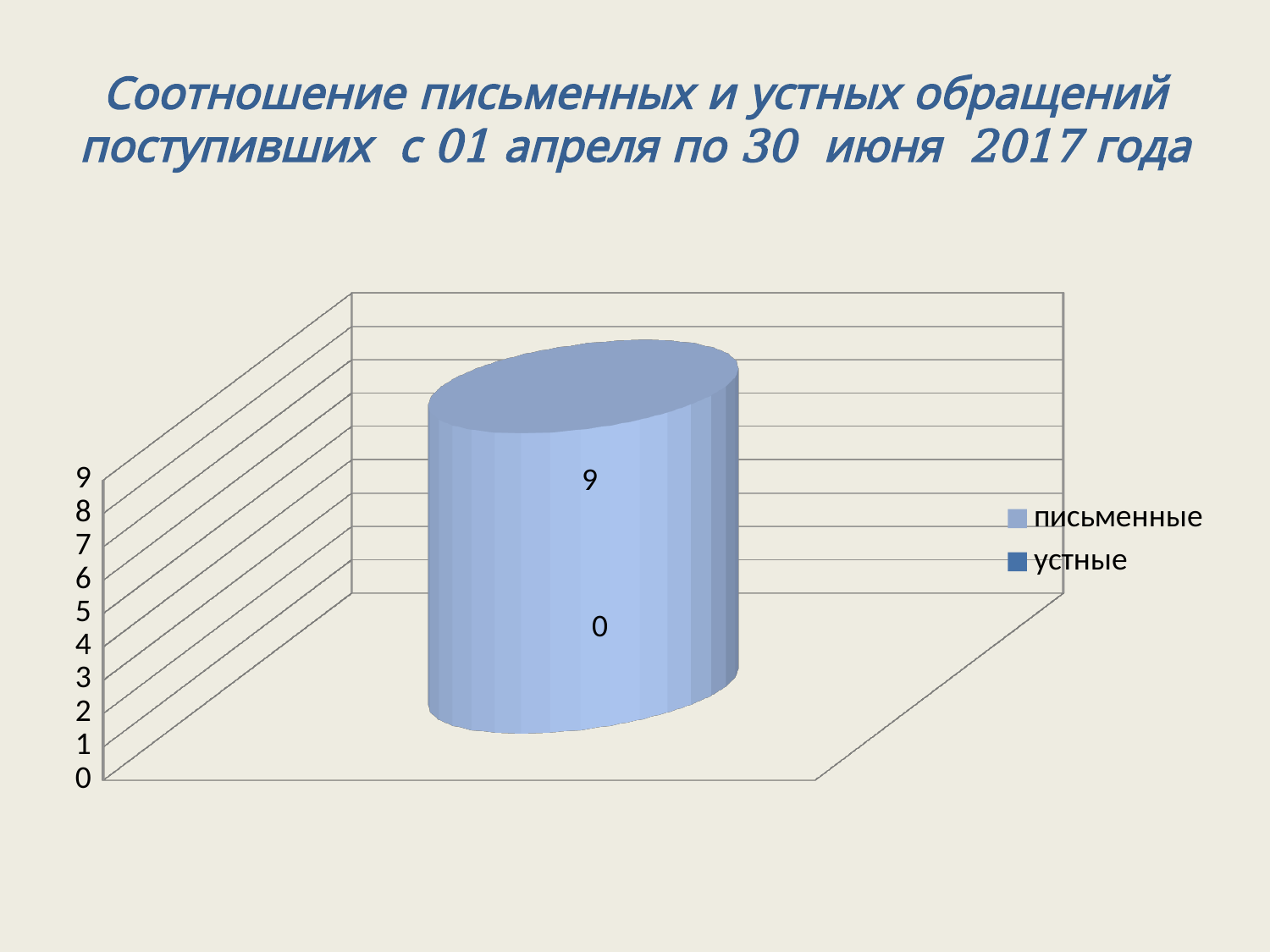
What is the difference between the values for письменные and устные? 9 What period does the chart title say the обращения were received in? с 01 апреля по 30 июня 2017 года What is the highest value shown on the vertical axis? 9 What kind of chart is shown on the slide? bar chart How many series does the legend list? 2 What is the total of the values for письменные and устные? 9 Which series has the higher value, письменные or устные? письменные Is the value for письменные greater or less than 5? greater What is the value for устные? 0 Which series has the highest value? письменные Which series has the lowest value? устные What is the value for письменные? 9